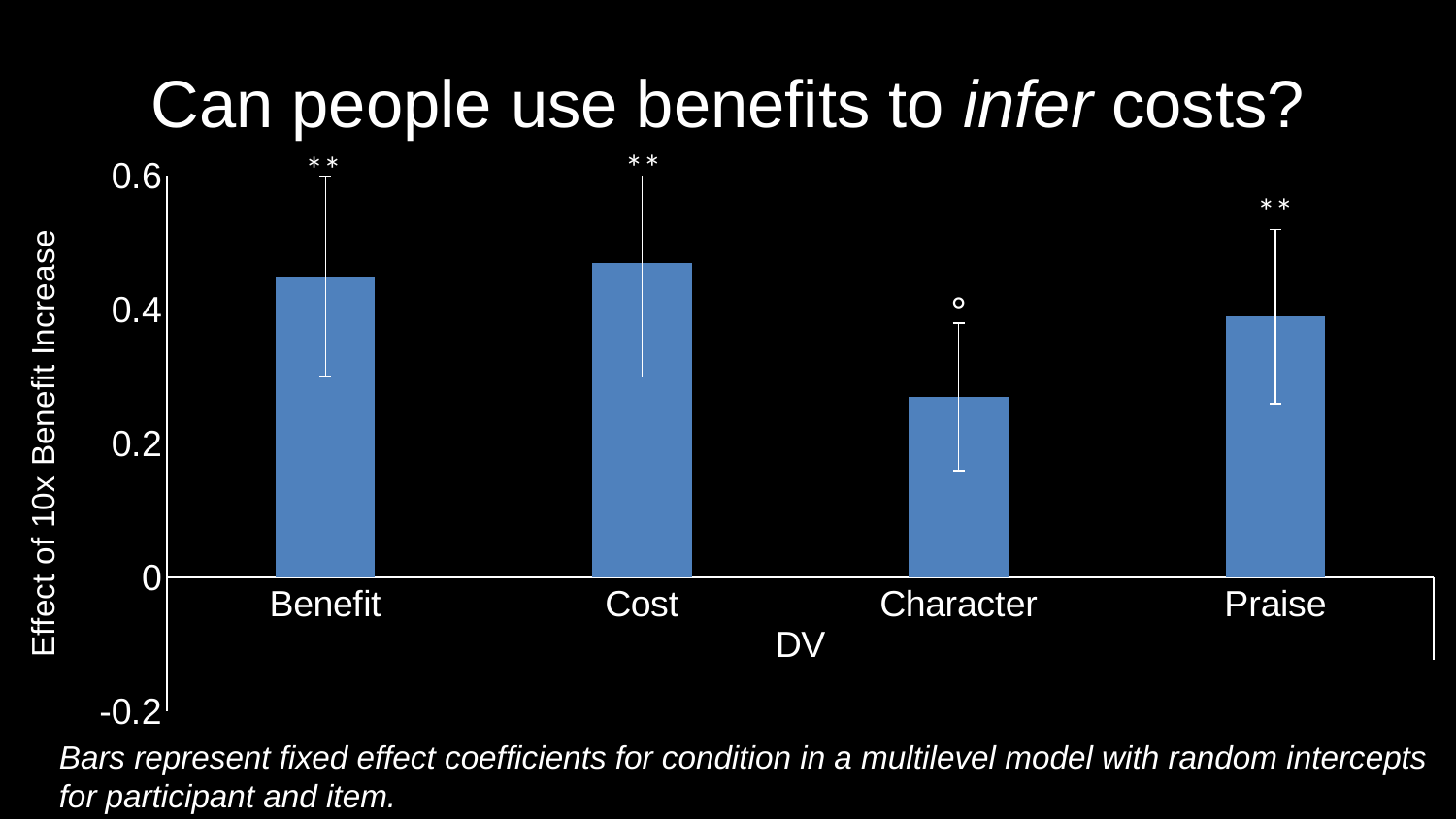
Which bar is taller, Cost or Praise? Cost Is the value for Cost greater or less than 0.4? greater Is the value for Praise greater or less than 0.2? greater Which bar is taller, Benefit or Character? Benefit Is the value for Character greater or less than 0.2? greater What is the label on the x axis? DV What is the label on the y axis? Effect of 10x Benefit Increase Which category has the lowest bar? Character What kind of chart is shown on the slide? bar chart How many categories are plotted on the x axis? 4